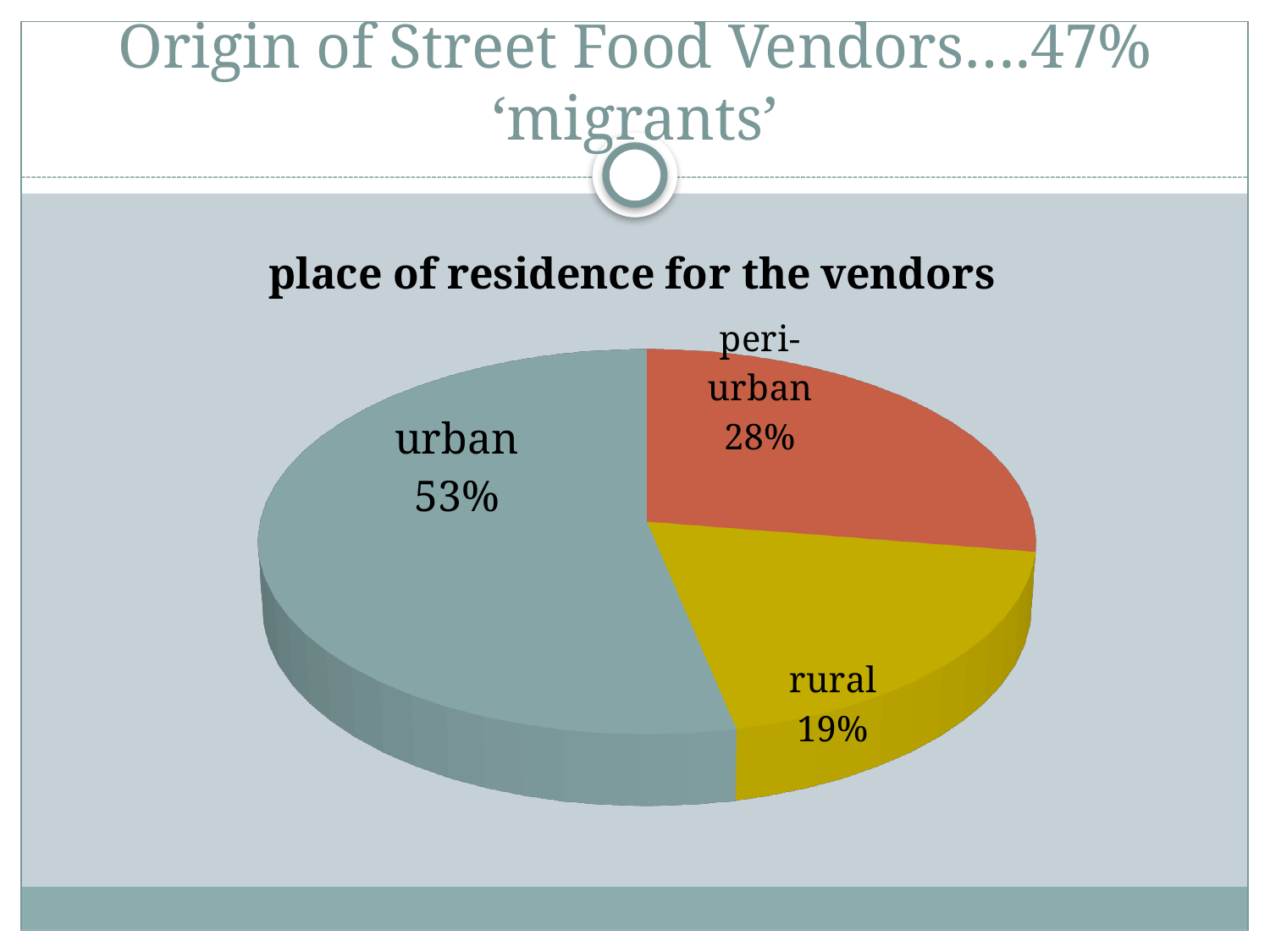
What kind of chart is shown on the slide? pie chart What is the difference in percentage points between the peri-urban and rural shares? 9 What colour is the urban slice? grey-green Which is larger, the peri-urban share or the rural share? peri-urban What share of vendors live in peri-urban areas? 28% What is the title of the chart? place of residence for the vendors Which place of residence has the largest share of vendors? urban What is the difference in percentage points between the urban and rural shares? 34 What share of vendors live in rural areas? 19% How many slices does the pie chart have? 3 What share of vendors live in urban areas? 53% Which place of residence has the smallest share of vendors? rural